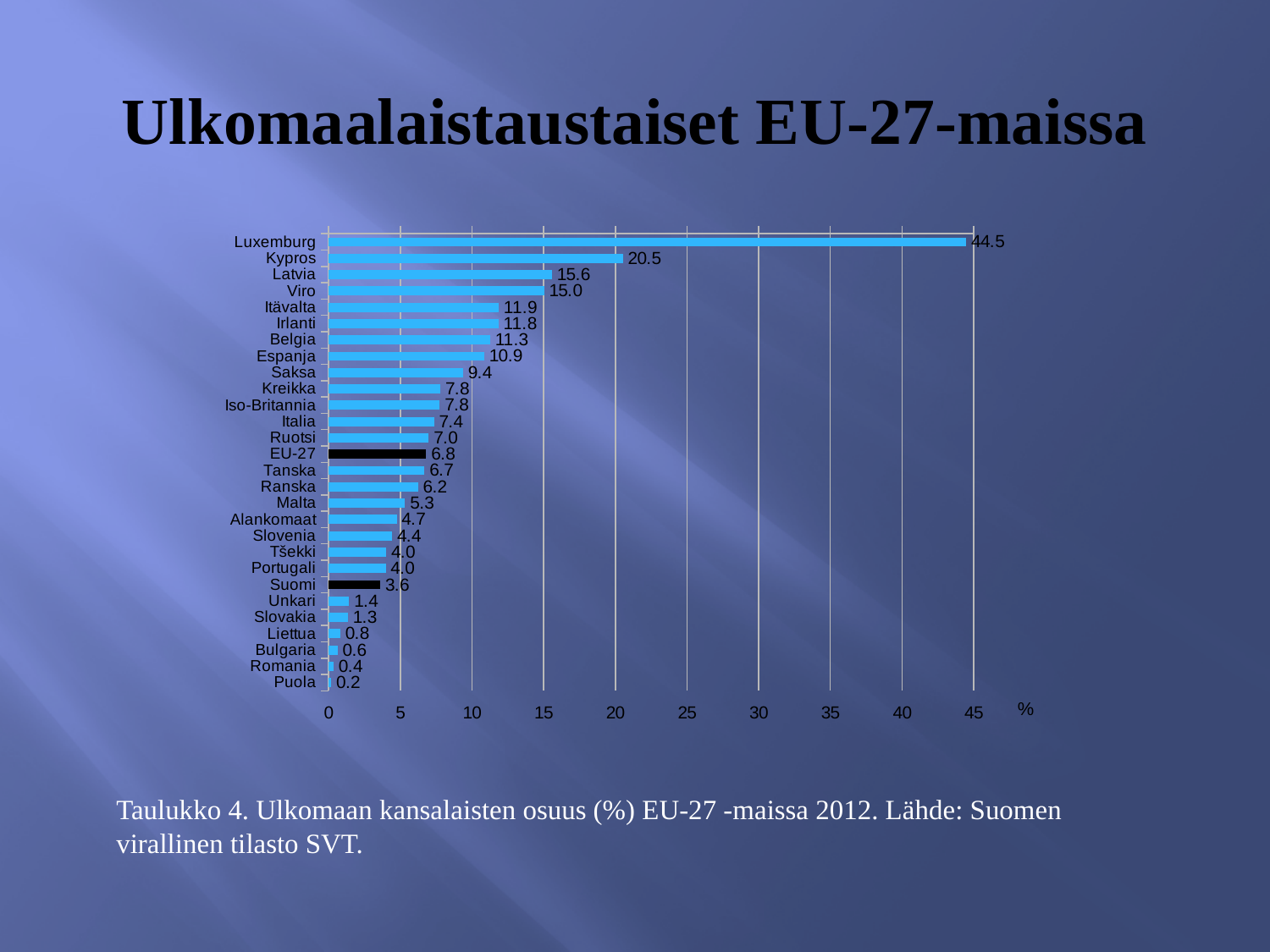
Which country has the highest value? Luxemburg What is the value for Luxemburg? 44.5 What kind of chart is shown on the slide? Bar chart Is the value for Viro greater or less than 10? greater How many bars are shown in the chart? 28 What is the difference between the values for Kypros and Latvia? 4.9 Which has a larger value, Saksa or Ruotsi? Saksa What is the difference between the values for EU-27 and Suomi? 3.2 Which two bars are coloured black instead of blue? EU-27 and Suomi Which country has the lowest value? Puola What is the value for Suomi? 3.6 What is the value for EU-27? 6.8